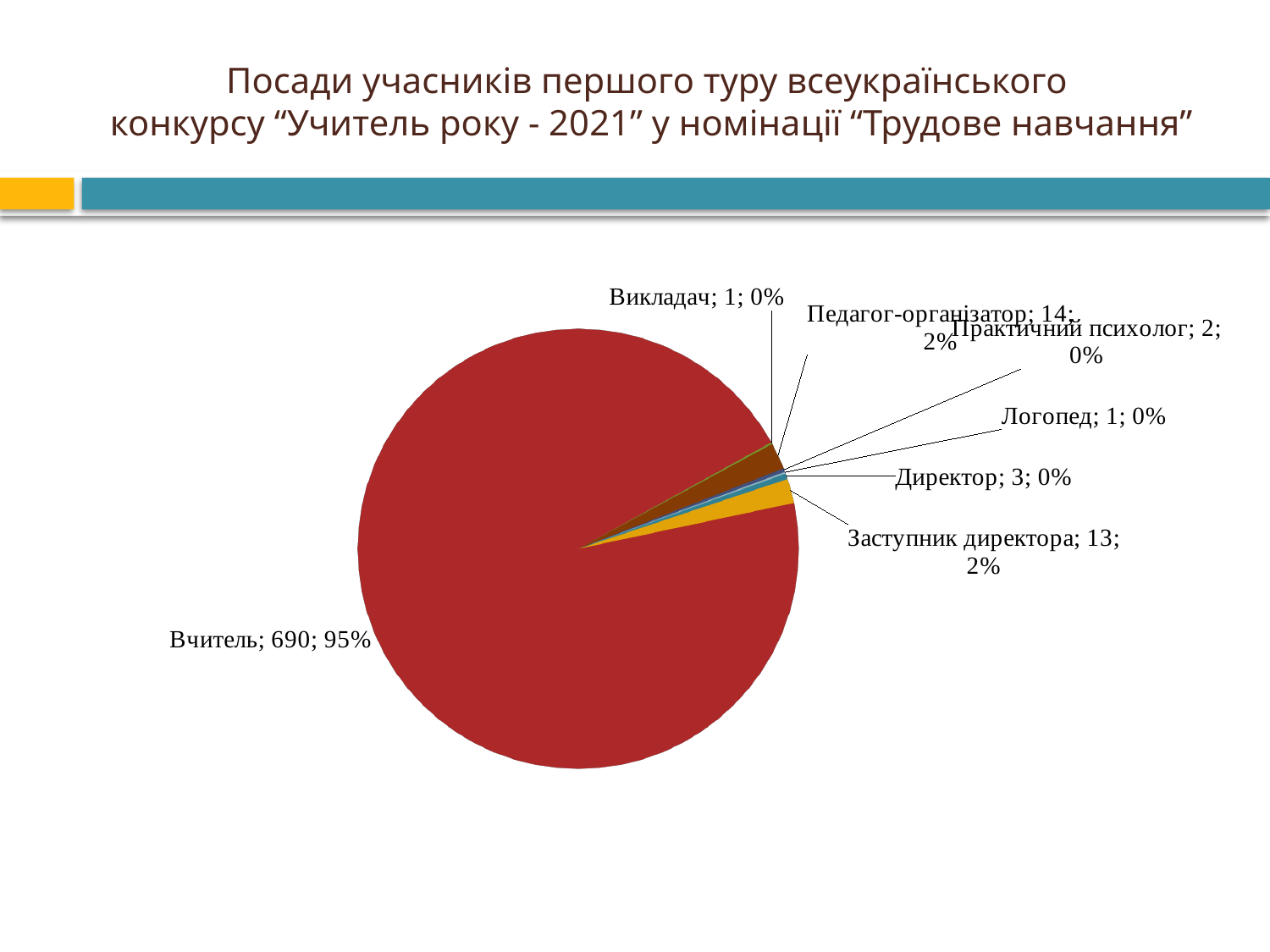
How many participants are labelled as Директор? 3 What share of the pie does the Вчитель slice represent? 95% How many categories (slices) does the pie chart have? 7 Which is larger, the number of Директор participants or the number of Логопед participants? Директор What kind of chart is shown on the slide? pie chart How many participants are labelled as Практичний психолог? 2 What is the difference between the number of Педагог-організатор and Заступник директора participants? 1 Which category has the largest slice of the pie? Вчитель How many participants are labelled as Педагог-організатор? 14 What share of the pie does the Заступник директора slice represent? 2% How many participants are labelled as Вчитель? 690 How many participants are labelled as Заступник директора? 13